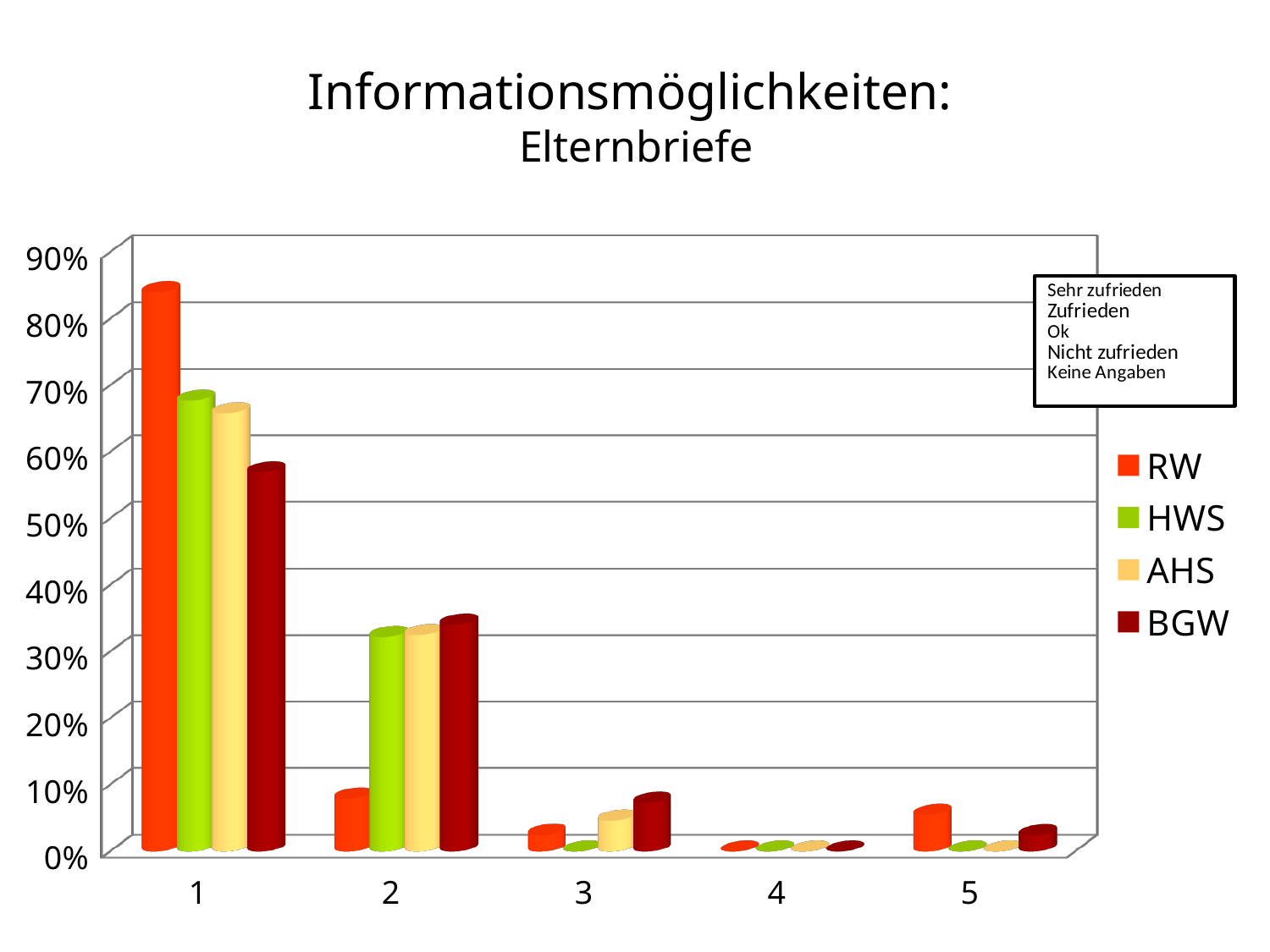
How many categories are shown on the x axis? 5 Do the values for RW rise or fall from category 1 to category 4? fall Is the value for RW in category 1 greater or less than 80%? greater Is the value for BGW in category 1 greater or less than 60%? less In category 2, which is larger, the value for RW or the value for HWS? HWS How many series does the legend list? 4 What kind of chart is shown on the slide? bar chart Is the value for HWS in category 1 greater or less than 60%? greater In category 3, which is larger, the value for BGW or the value for RW? BGW Which series has the lowest value for category 1? BGW Which series has the highest value for category 1? RW